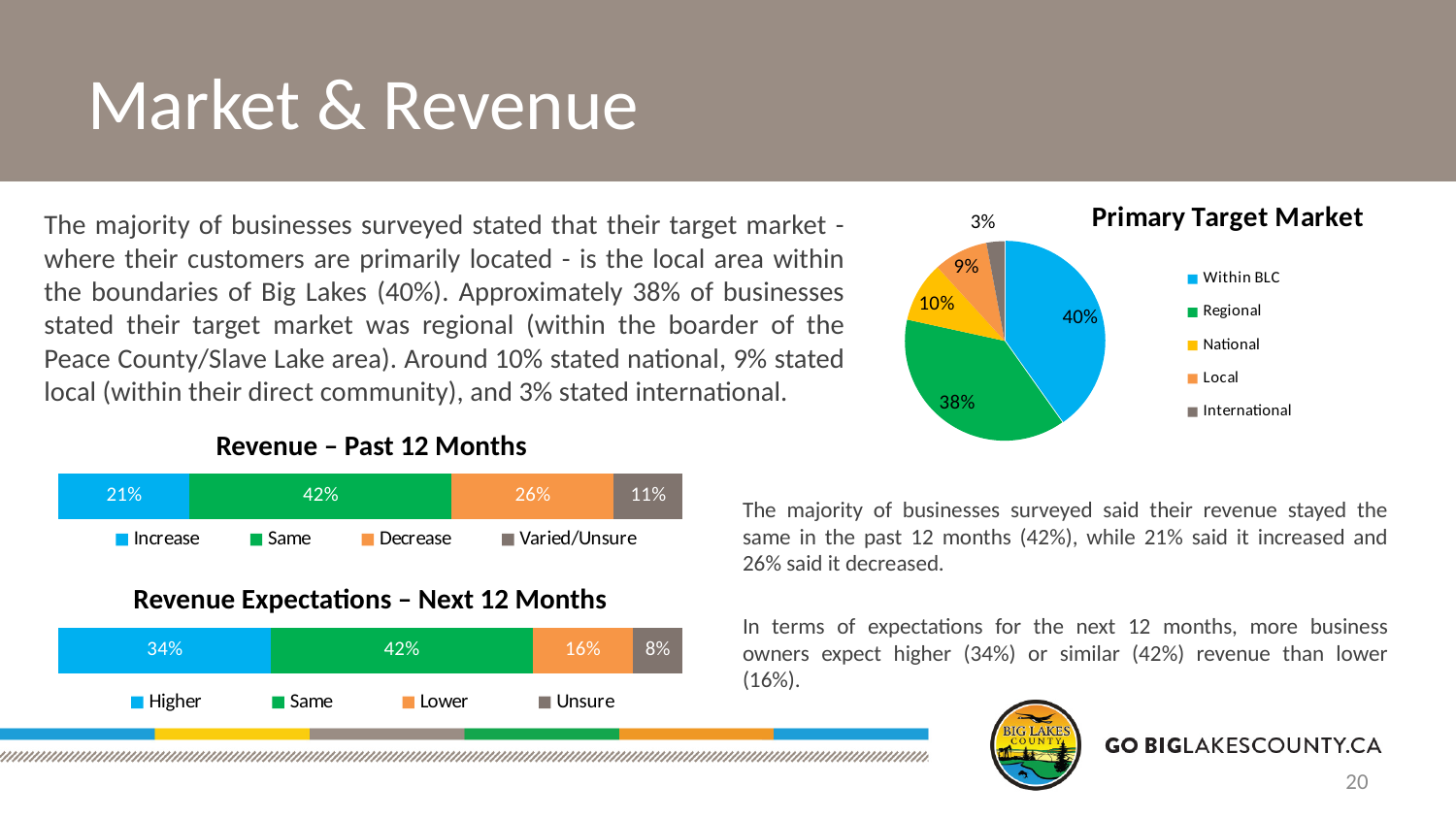
In the Revenue Expectations – Next 12 Months chart, what is the difference between Higher and Lower? 18% What kind of chart is the Primary Target Market chart? Pie chart In the Primary Target Market pie chart, which category has the smallest slice? International In the Primary Target Market pie chart, which category has the largest slice? Within BLC In the Primary Target Market pie chart, what share of businesses is labelled Within BLC? 40% In the Revenue Expectations – Next 12 Months chart, what percentage of business owners expect Lower revenue? 16% In the Primary Target Market pie chart, what is the difference between the Within BLC and Regional shares? 2% In the Revenue – Past 12 Months chart, which is larger, Increase or Decrease? Decrease In the Primary Target Market pie chart, how many categories does the legend list? 5 In the Revenue – Past 12 Months chart, what percentage of businesses said revenue stayed the Same? 42% What kind of chart is the Revenue Expectations – Next 12 Months chart? Stacked bar chart In the Revenue – Past 12 Months chart, what is the value for Varied/Unsure? 11%